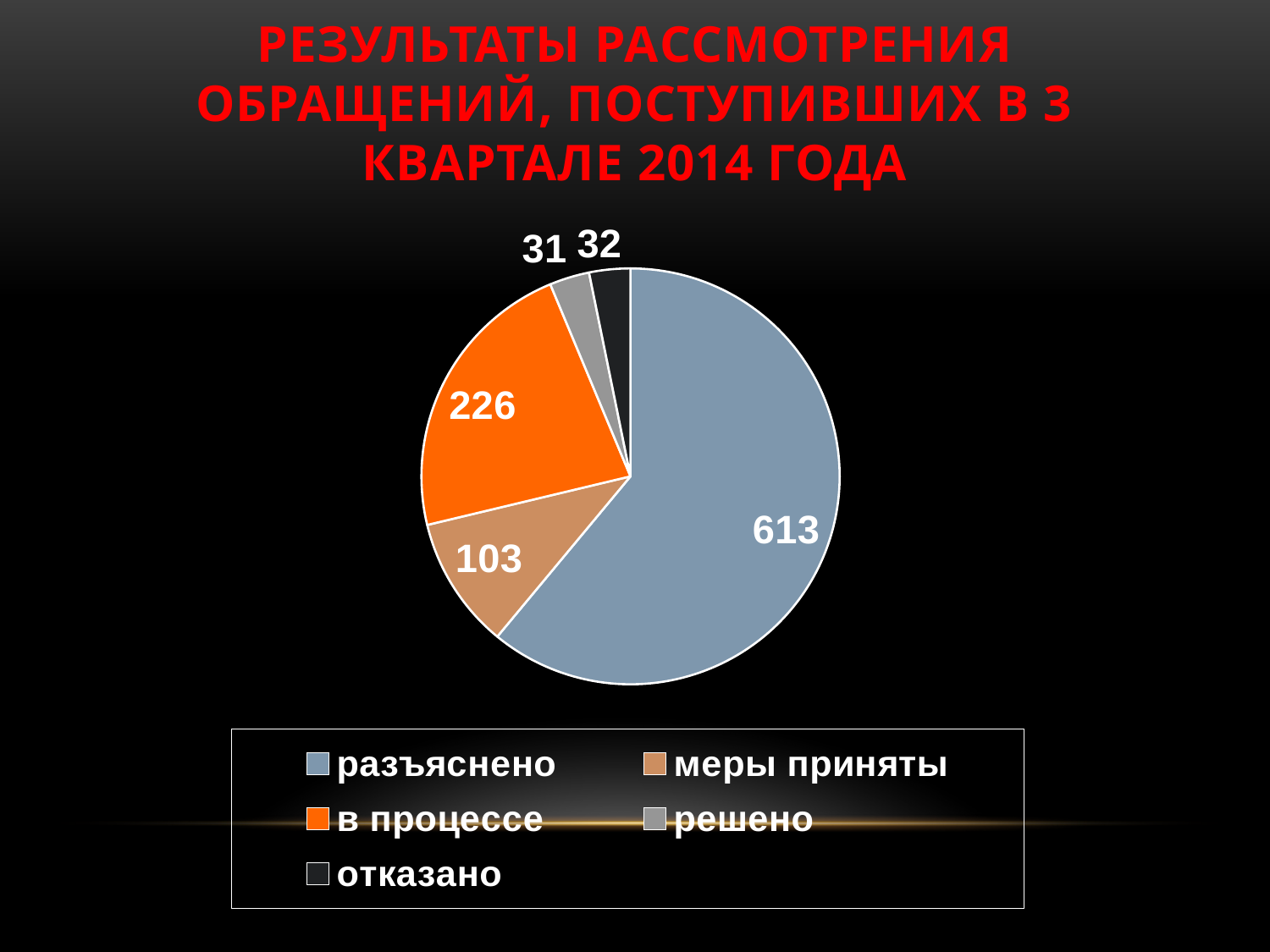
Which is larger, the value for в процессе or the value for меры приняты? в процессе What is the difference between the values for разъяснено and в процессе? 387 What is the value for меры приняты? 103 What kind of chart is shown on the slide? pie chart Which category has the largest slice of the pie? разъяснено Which category has the smallest slice of the pie? решено What is the value for разъяснено? 613 How many categories does the pie chart have? 5 What is the total of all the values shown in the pie chart? 1005 What is the value for отказано? 32 What is the value for в процессе? 226 What colour is the slice for в процессе? orange